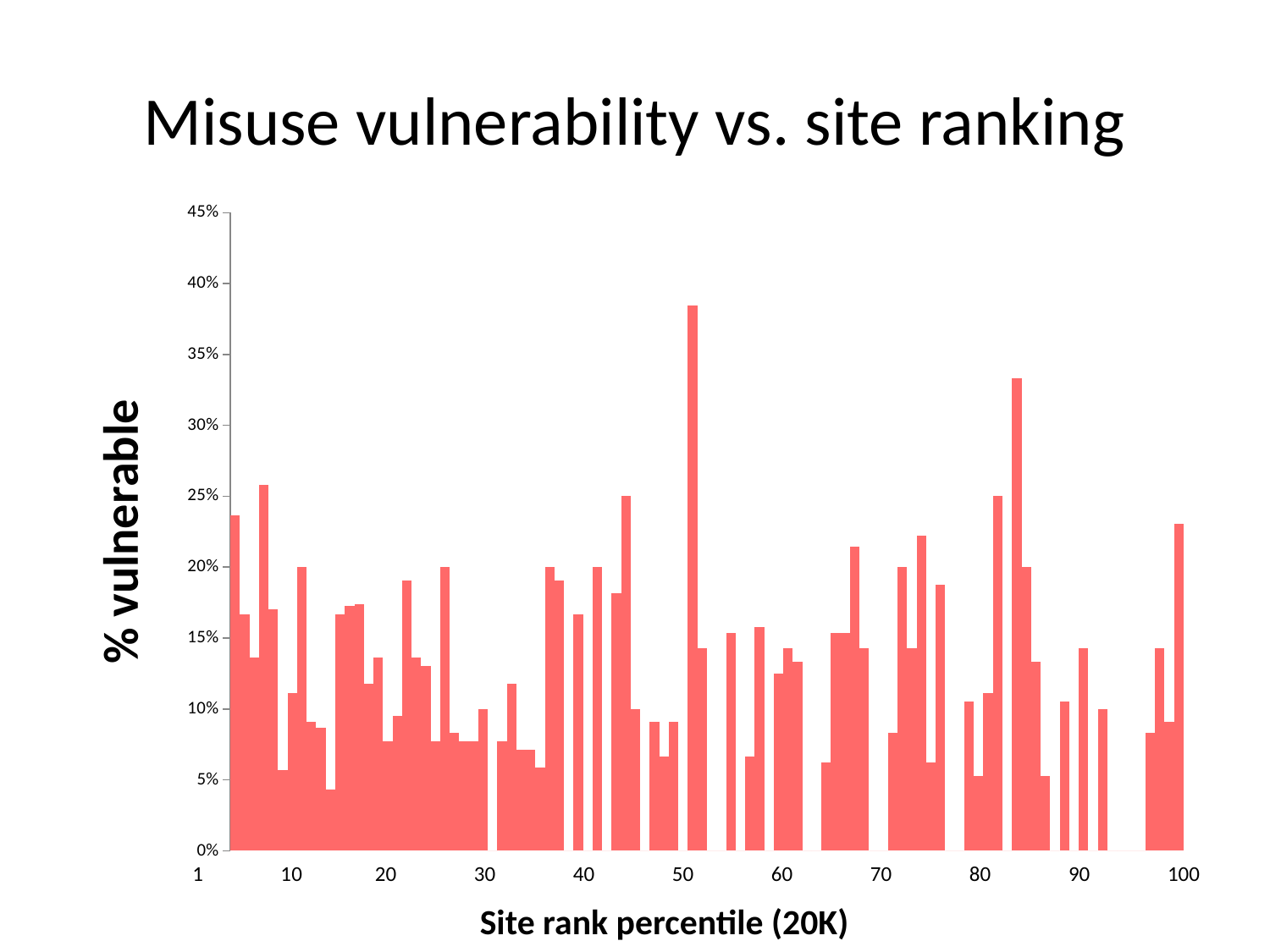
Is the second-tallest bar, located between the 80 and 90 ticks, greater or less than 30%? greater Do the values show a steady rise or fall as site rank percentile increases from 1 to 100? no clear trend What kind of chart is shown on the slide? bar chart Does any bar in the chart exceed 40%? no Is the tallest bar in the chart greater or less than 35%? greater What is the highest value shown on the y axis? 45% Is the tallest bar located closer to the 50 tick or the 80 tick on the x axis? 50 What is the title of the chart? Misuse vulnerability vs. site ranking What is the label of the x axis? Site rank percentile (20K)